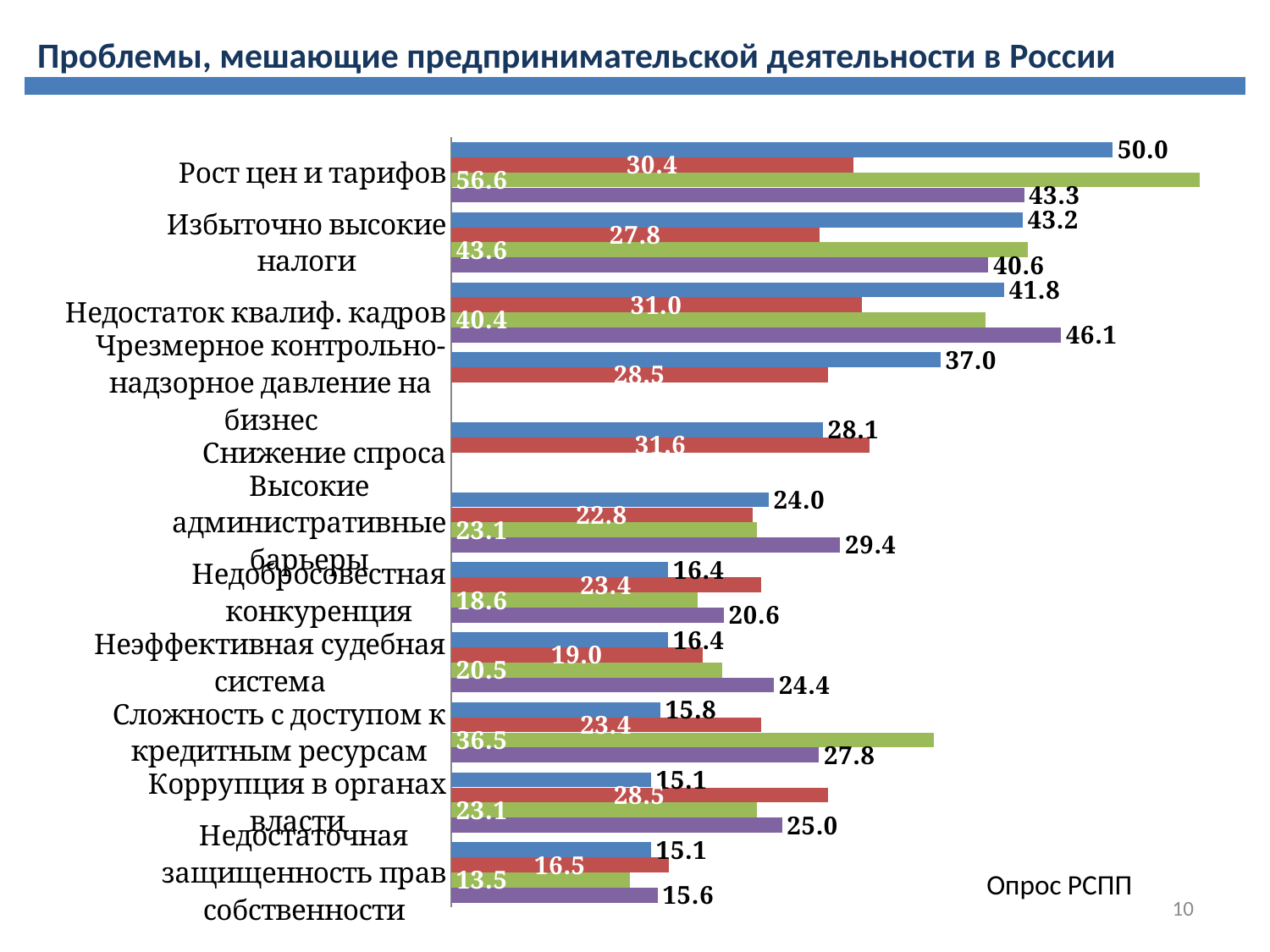
How many categories (problems) are listed on the chart? 11 What is the value of the red bar for "Снижение спроса"? 31.6 What is the value of the purple bar for "Недостаток квалиф. кадров"? 46.1 What source is cited in the bottom right corner of the chart? Опрос РСПП What is the value of the blue bar for "Рост цен и тарифов"? 50.0 What kind of chart is shown on the slide? bar chart Which category has the highest value for the blue bars? Рост цен и тарифов What is the title of the chart? Проблемы, мешающие предпринимательской деятельности в России What is the value of the green bar for "Рост цен и тарифов"? 56.6 For "Недостаток квалиф. кадров", which is larger: the green bar or the purple bar? the purple bar What is the difference between the blue bar (50.0) and the red bar (30.4) for "Рост цен и тарифов"? 19.6 Which category has the lowest value for the purple bars? Недостаточная защищенность прав собственности